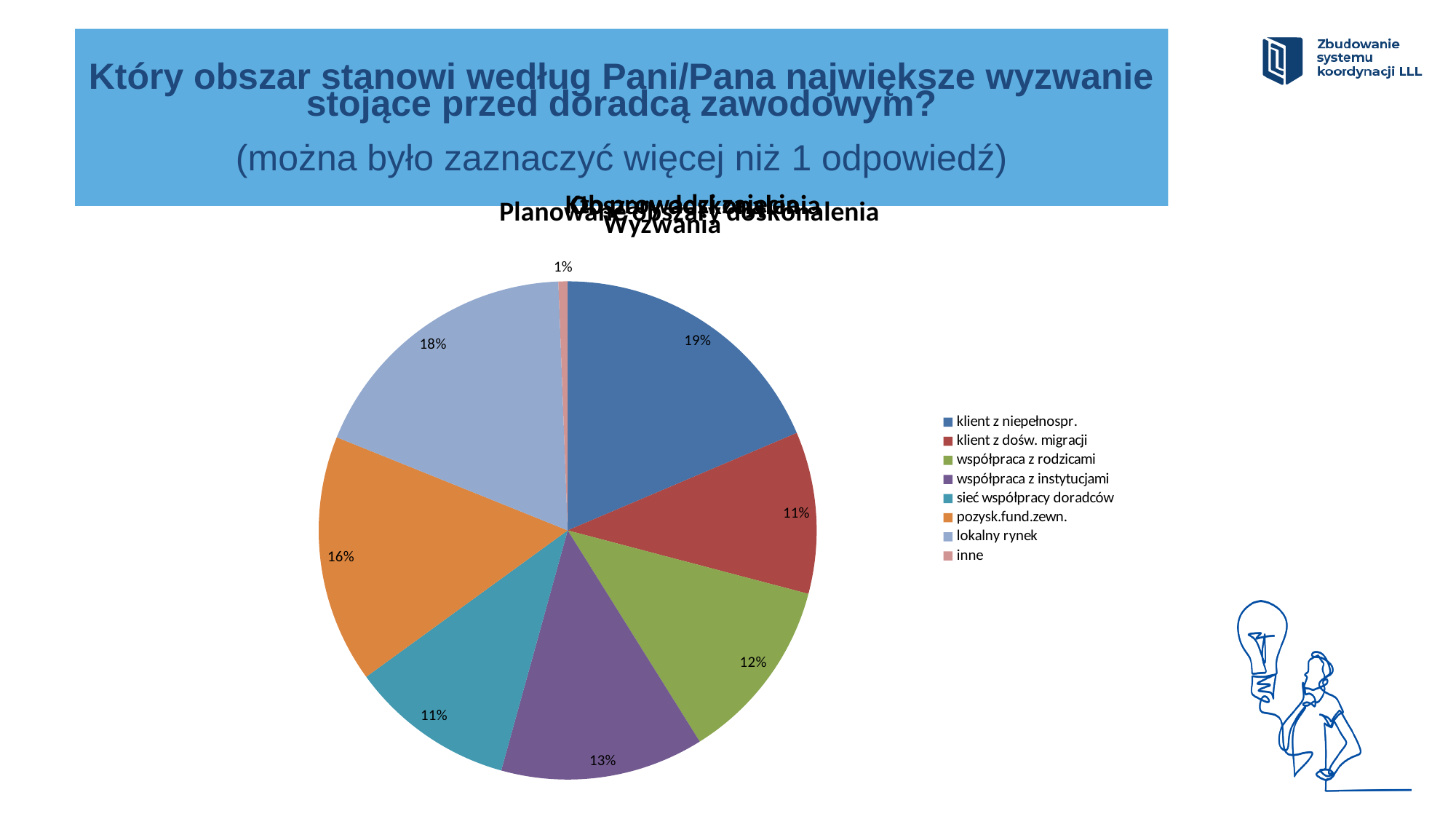
How many categories does the legend list? 8 Which is larger, the share for "pozysk.fund.zewn." or the share for "współpraca z instytucjami"? pozysk.fund.zewn. What share of the pie does "inne" have? 1% What kind of chart is shown on the slide? pie chart Which category has the largest slice of the pie? klient z niepełnospr. Which category has the smallest slice of the pie? inne What is the difference in percentage points between "klient z niepełnospr." and "współpraca z rodzicami"? 7 What share of the pie does "klient z niepełnospr." have? 19% What share of the pie does "lokalny rynek" have? 18% What colour is the slice for "pozysk.fund.zewn."? orange